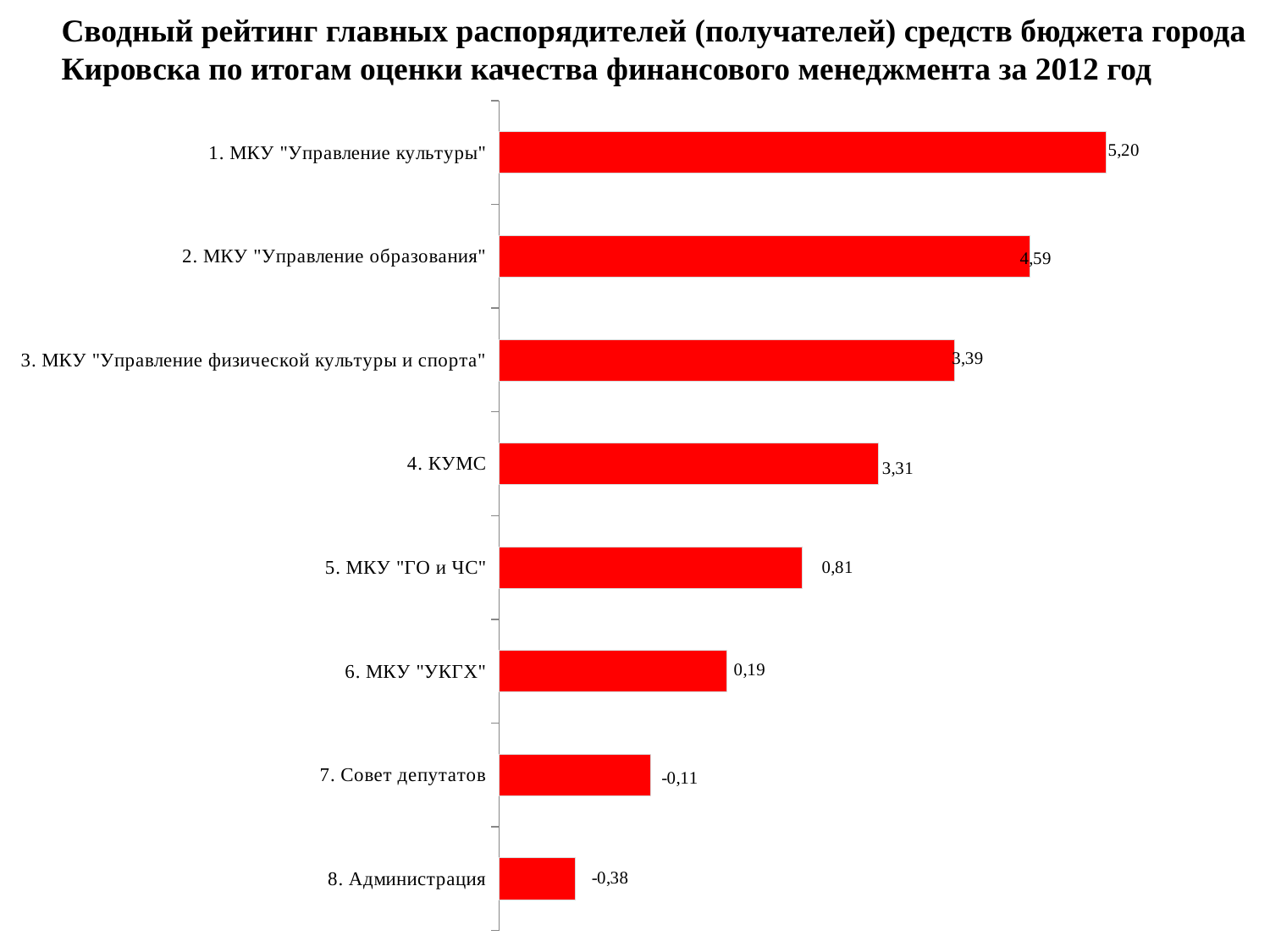
What is the value for 5. МКУ "ГО и ЧС"? 0,81 Which category has the highest value? 1. МКУ "Управление культуры" What kind of chart is shown on the slide? Bar chart What is the value for 4. КУМС? 3,31 What is the value for 7. Совет депутатов? -0,11 What is the value for 1. МКУ "Управление культуры"? 5,20 What is the difference between the values for 5. МКУ "ГО и ЧС" and 6. МКУ "УКГХ"? 0,62 What colour are the bars in the chart? Red How many categories are shown in the chart? 8 Which category has the lowest value? 8. Администрация What is the difference between the values for 1. МКУ "Управление культуры" and 2. МКУ "Управление образования"? 0,61 Which has a larger value, 3. МКУ "Управление физической культуры и спорта" or 4. КУМС? 3. МКУ "Управление физической культуры и спорта"